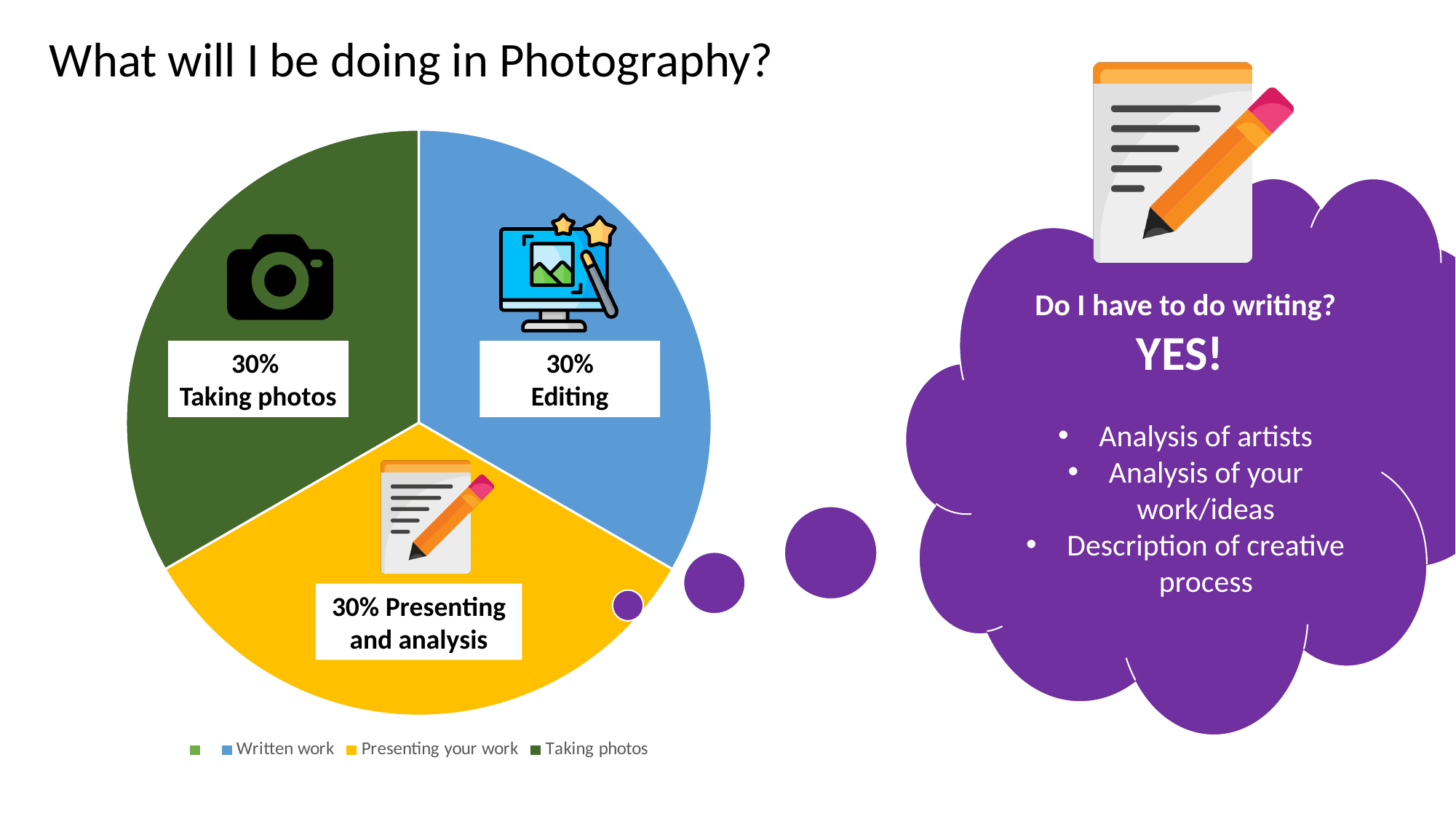
What percentage is shown for the Taking photos slice? 30% How many slices does the pie chart have? 3 What colour is the Editing slice of the pie chart? Blue Is the Taking photos slice larger, smaller, or the same size as the Editing slice? The same size What kind of chart is shown on the slide? Pie chart What share of the pie does the Editing slice represent? 30% What percentage is shown for the Presenting and analysis slice? 30% What percentage is shown for the Editing slice? 30% What colour is the Taking photos slice of the pie chart? Dark green Which slice of the pie chart is yellow? Presenting and analysis What is the difference between the Taking photos percentage and the Presenting and analysis percentage? 0%